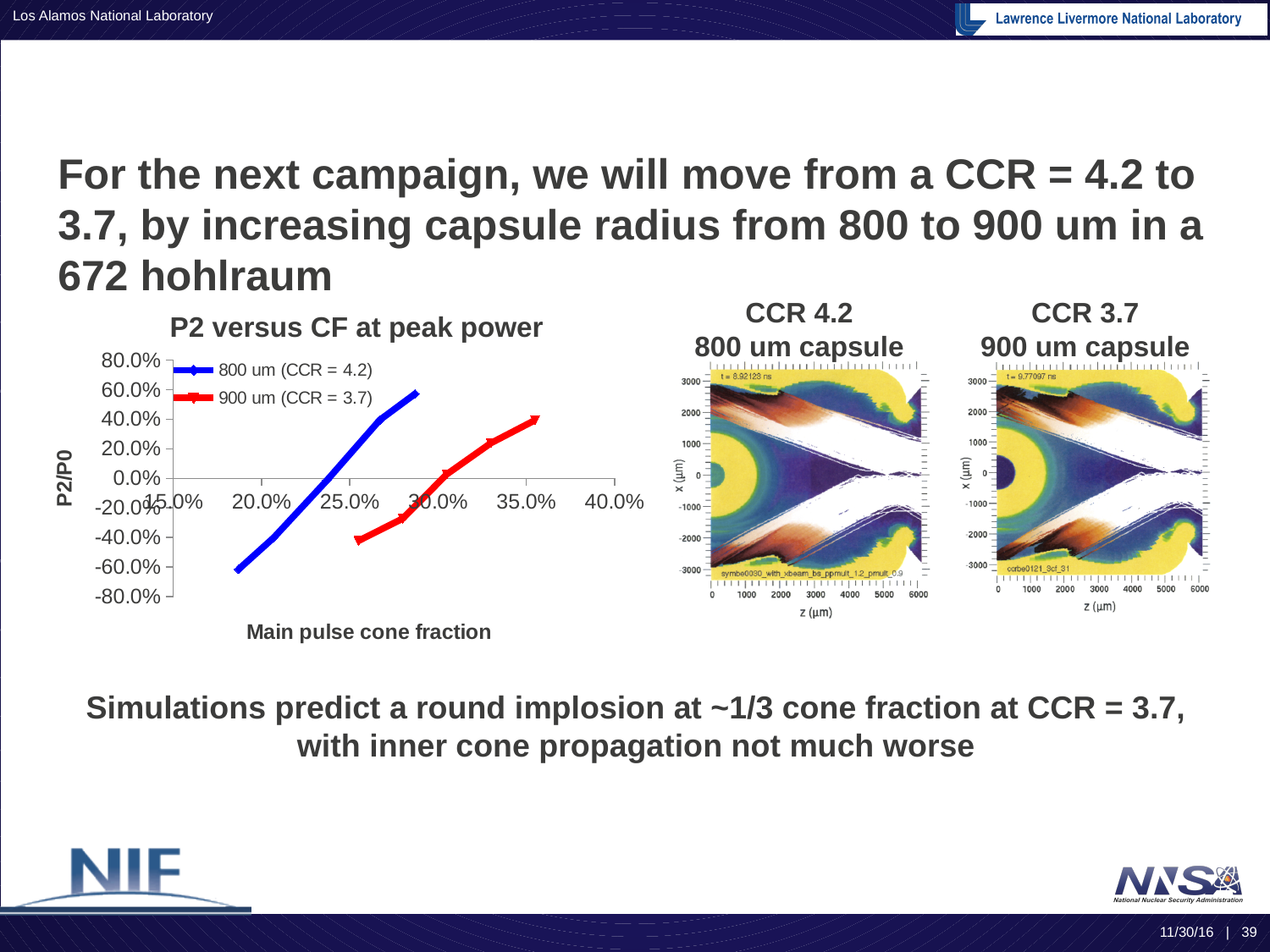
What is the x-axis label of the 'P2 versus CF at peak power' chart? Main pulse cone fraction In the 'P2 versus CF at peak power' chart, which series is drawn in red? 900 um (CCR = 3.7) In the 'P2 versus CF at peak power' chart, is the P2/P0 value for the 900 um (CCR = 3.7) series at a 35.0% cone fraction greater or less than 20.0%? greater In the 'P2 versus CF at peak power' chart, which series starts at the lower P2/P0 value, 800 um (CCR = 4.2) or 900 um (CCR = 3.7)? 800 um (CCR = 4.2) In the 'P2 versus CF at peak power' chart, does the 800 um (CCR = 4.2) series rise or fall as cone fraction increases? rise In the 'P2 versus CF at peak power' chart, is the P2/P0 value for the 900 um (CCR = 3.7) series at a 26.0% cone fraction greater or less than -20.0%? less How many series does the legend of the 'P2 versus CF at peak power' chart list? 2 In the 'P2 versus CF at peak power' chart, does the 900 um (CCR = 3.7) series rise or fall as cone fraction increases? rise What kind of chart is 'P2 versus CF at peak power'? line chart In the 'P2 versus CF at peak power' chart, is the P2/P0 value for the 800 um (CCR = 4.2) series at a 20.0% cone fraction greater or less than -40.0%? less In the 'P2 versus CF at peak power' chart, which series reaches the higher maximum P2/P0 value, 800 um (CCR = 4.2) or 900 um (CCR = 3.7)? 800 um (CCR = 4.2) What is the title of the line chart on the slide? P2 versus CF at peak power